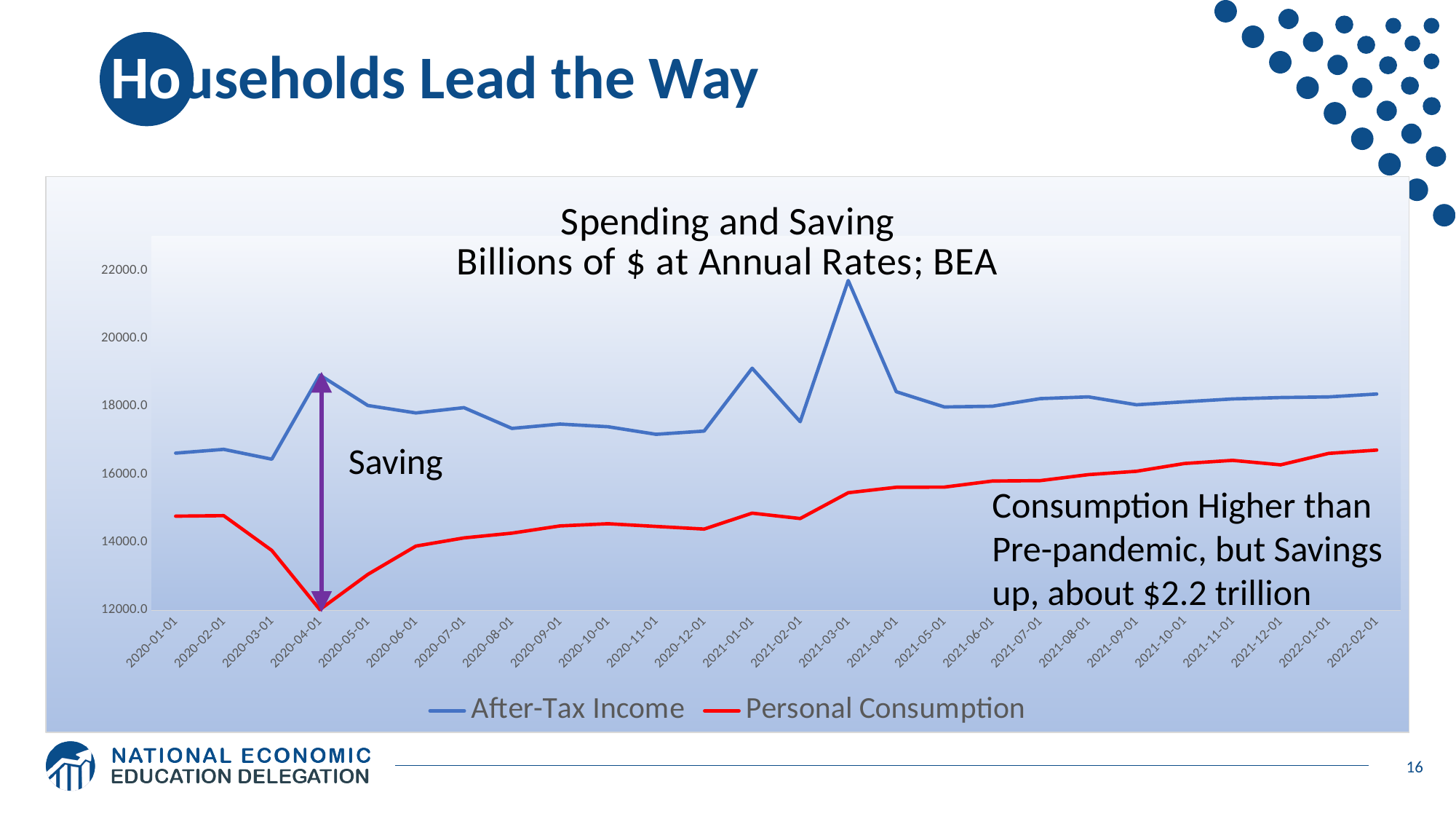
At which date does After-Tax Income reach its highest value? 2021-03-01 Does Personal Consumption generally rise or fall from 2020-04-01 to 2022-02-01? Rise How many series does the legend list? 2 What are the two series named in the legend? After-Tax Income and Personal Consumption At which date does Personal Consumption reach its lowest value? 2020-04-01 Is the value for Personal Consumption at 2020-04-01 greater or less than 14000.0? less What is the title of the chart? Spending and Saving Billions of $ at Annual Rates; BEA Is the value for Personal Consumption at 2022-02-01 greater or less than 16000.0? greater Is the value for After-Tax Income at 2021-03-01 greater or less than 20000.0? greater Which series has the larger value at 2021-03-01, After-Tax Income or Personal Consumption? After-Tax Income What kind of chart is shown on the slide? Line chart How many monthly data points are plotted along the x axis? 26